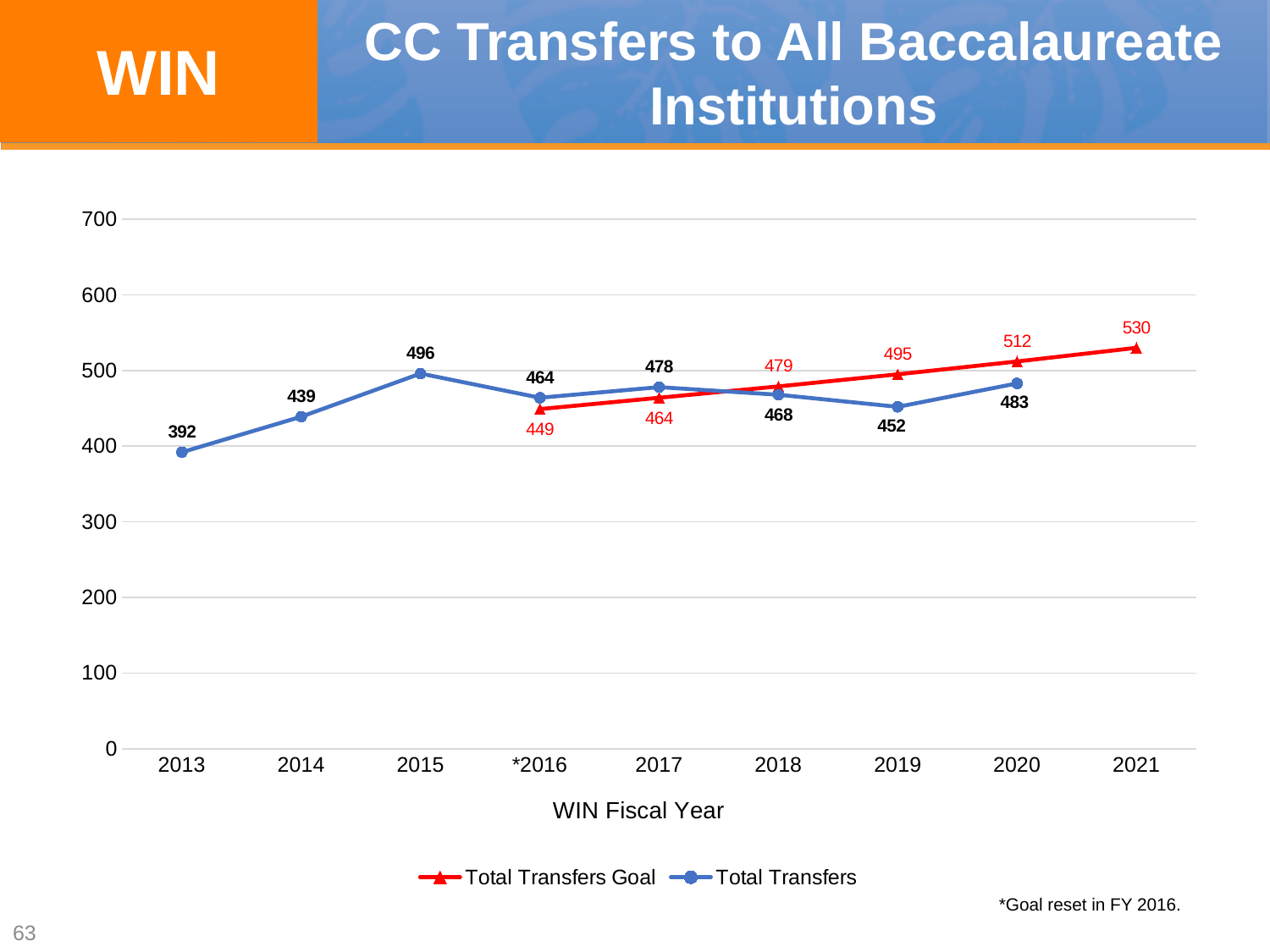
Does the Total Transfers Goal series rise or fall from 2016 to 2021? Rise How many series does the legend list? 2 How many years are shown on the x axis? 9 What is the difference between the Total Transfers Goal and the Total Transfers in 2019? 43 What is the Total Transfers Goal for 2021? 530 In 2020, which is larger: the Total Transfers Goal or the Total Transfers? Total Transfers Goal What is the Total Transfers value for 2013? 392 What is the Total Transfers Goal for 2019? 495 What is the Total Transfers value for 2015? 496 Which year has the lowest Total Transfers value? 2013 What kind of chart is shown on the slide? Line chart Which year has the highest Total Transfers value? 2015